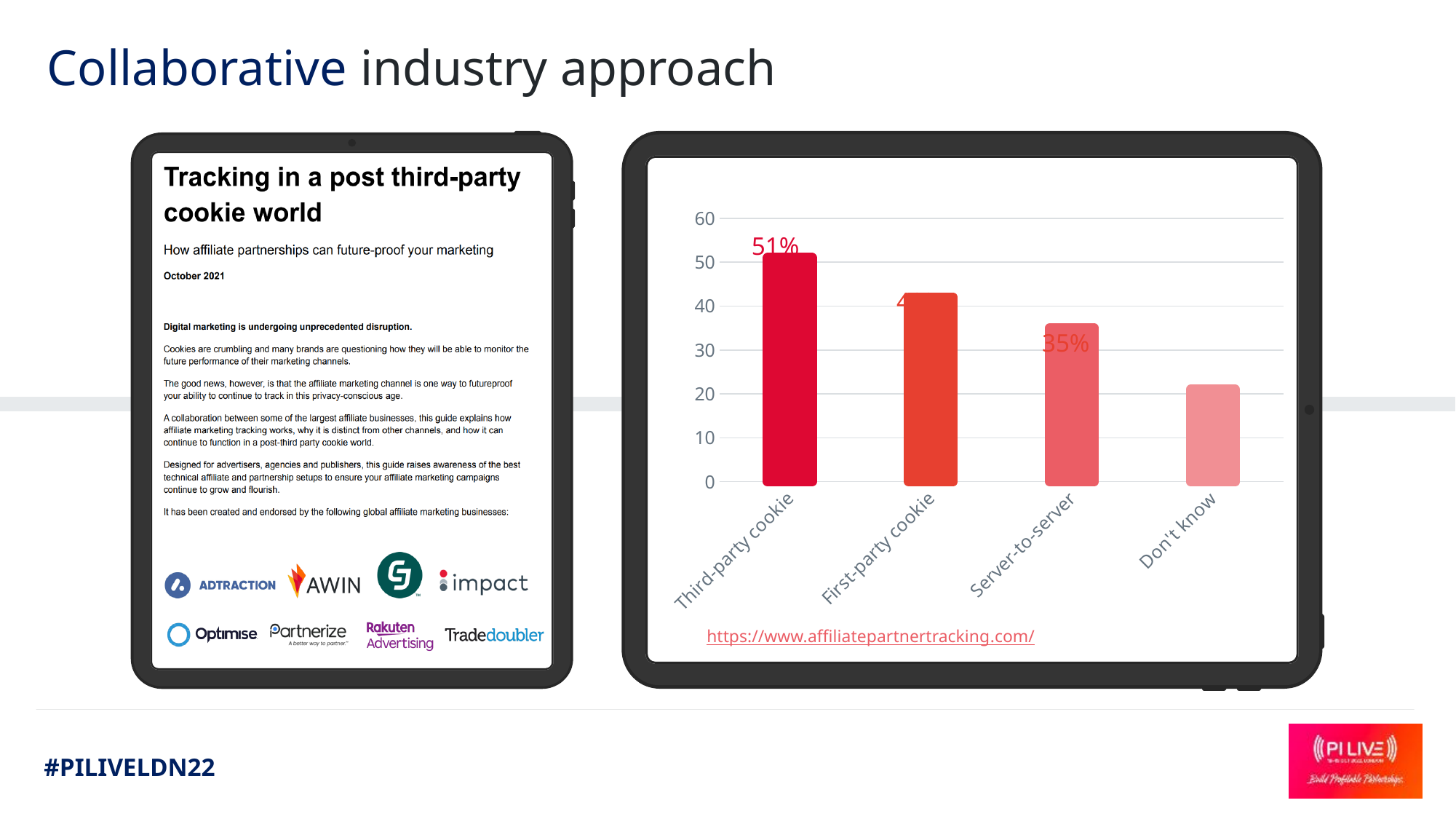
Which is larger, the value for First-party cookie or the value for Server-to-server? First-party cookie How many categories are shown on the x axis of the chart? 4 What is the value for Third-party cookie? 51% What kind of chart is shown on the slide? bar chart What URL is shown below the chart? https://www.affiliatepartnertracking.com/ Is the value for Don't know greater or less than 30? less Which category has the highest value? Third-party cookie Is the value for First-party cookie greater or less than 40? greater What is the value for Server-to-server? 35% Do the values rise or fall from left to right along the x axis? fall Which category has the lowest value? Don't know What is the difference between the values for Third-party cookie and Server-to-server? 16%